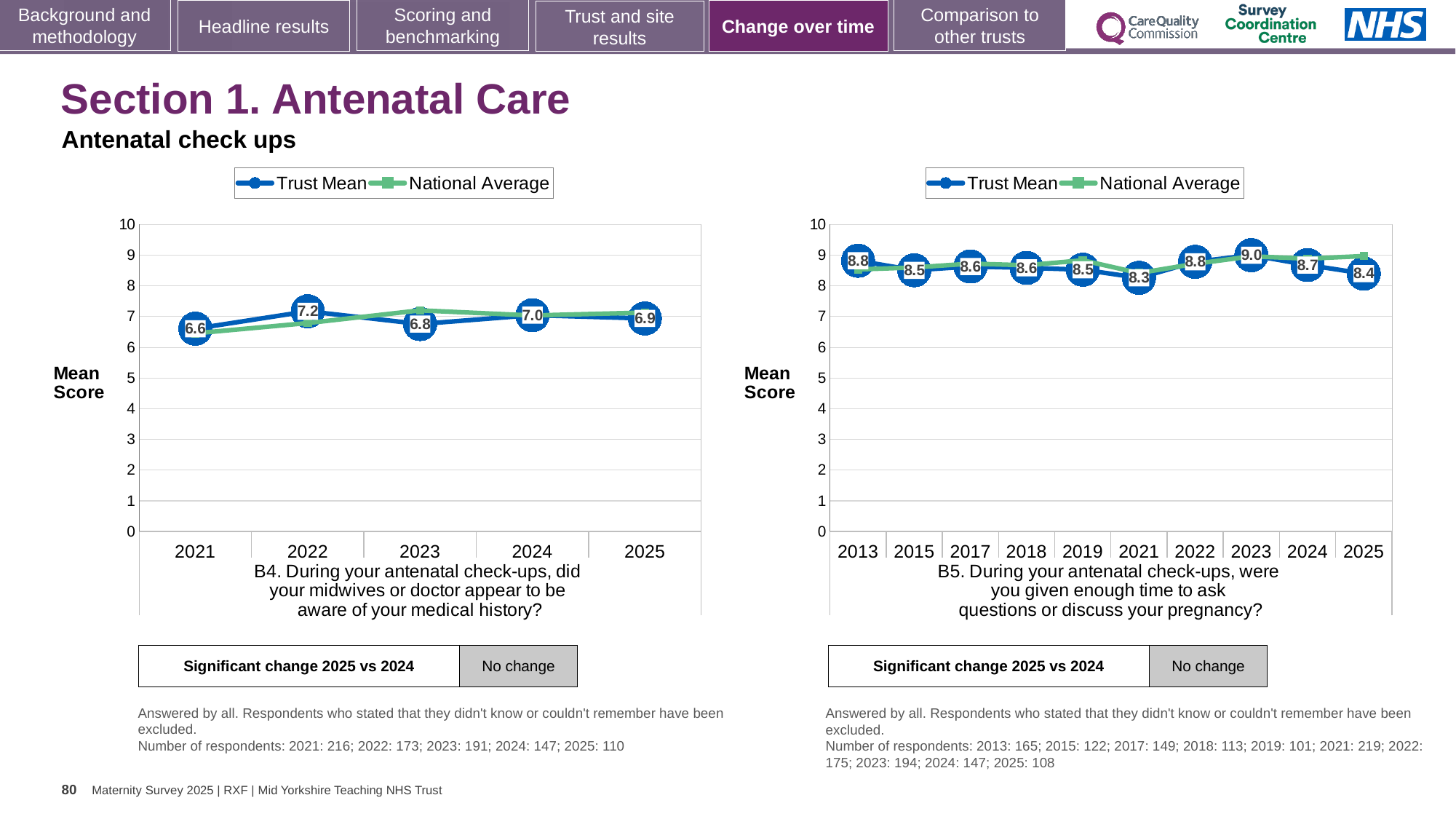
In the left chart (B4), which year has the highest Trust Mean score? 2022 In the right chart (B5), which year has the lowest Trust Mean score? 2021 How many series does the legend of the left chart (B4) list? 2 In the right chart (B5), what is the Trust Mean score for 2021? 8.3 In the right chart (B5), is the Trust Mean score higher in 2013 or in 2025? 2013 In the left chart (B4), what is the Trust Mean score for 2022? 7.2 In the right chart (B5), which year has the highest Trust Mean score? 2023 In the left chart (B4), what is the difference between the Trust Mean scores for 2022 and 2021? 0.6 In the right chart (B5), what is the Trust Mean score for 2023? 9.0 In the left chart (B4), which year has the lowest Trust Mean score? 2021 In the left chart (B4), what is the Trust Mean score for 2021? 6.6 In the right chart (B5), how many years are shown on the x axis? 10